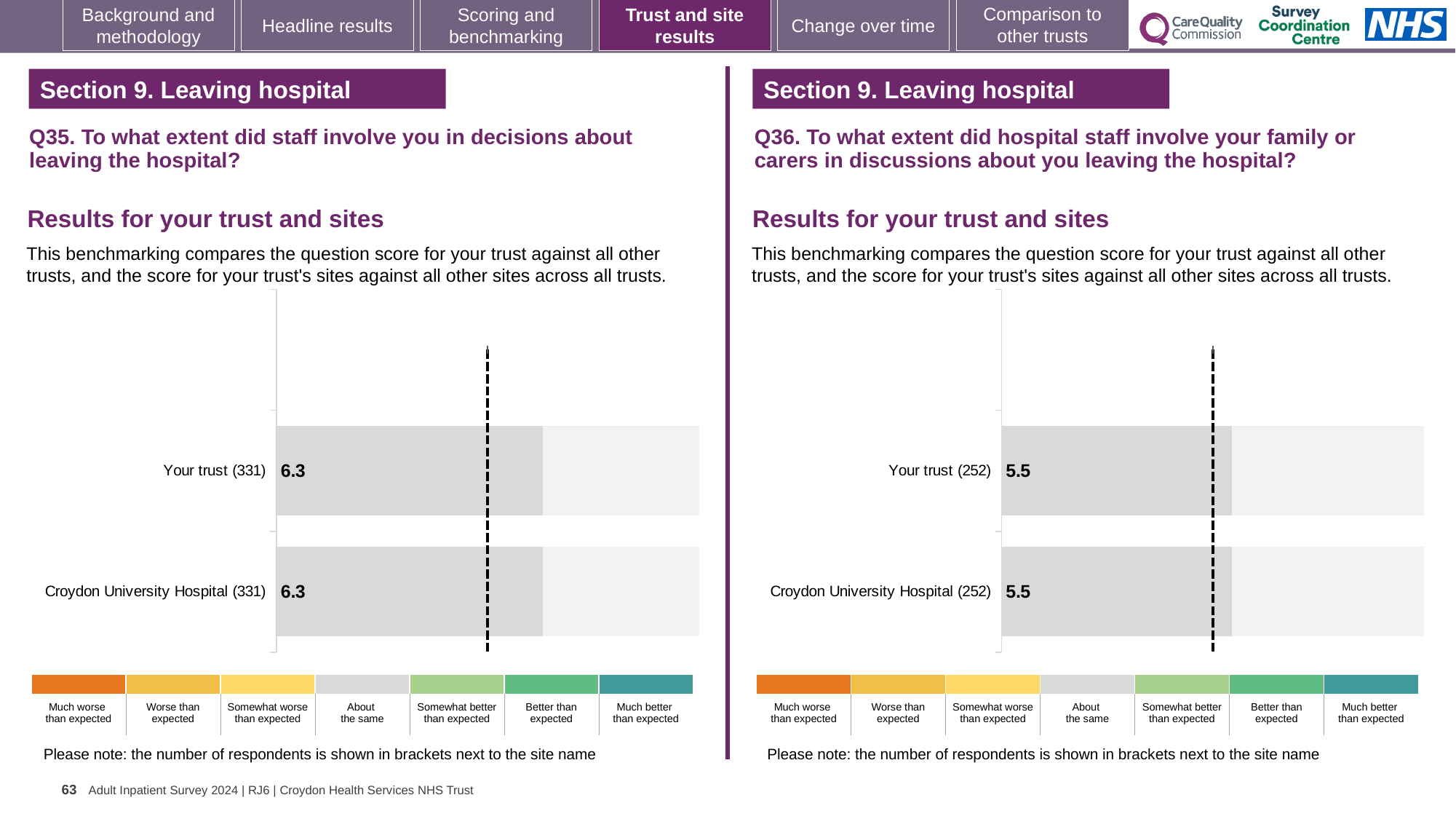
What kind of chart is used for the Q35 results on the left? Bar chart How many bars are plotted in the Q36 chart on the right? 2 How many bars are plotted in the Q35 chart on the left? 2 In the Q35 chart on the left, what is the score for Your trust? 6.3 In the Q36 chart on the right, what is the score for Croydon University Hospital? 5.5 In the Q36 chart on the right, how many respondents are shown in brackets next to Croydon University Hospital? 252 Is the score for Your trust in the Q35 chart on the left larger than the score for Your trust in the Q36 chart on the right? Yes In the Q35 chart on the left, what is the score for Croydon University Hospital? 6.3 In the Q36 chart on the right, what is the score for Your trust? 5.5 In the Q35 chart on the left, what is the difference between the score for Your trust and the score for Croydon University Hospital? 0 In the Q35 chart on the left, how many respondents are shown in brackets next to Your trust? 331 In the Q36 chart on the right, what is the difference between the score for Your trust and the score for Croydon University Hospital? 0